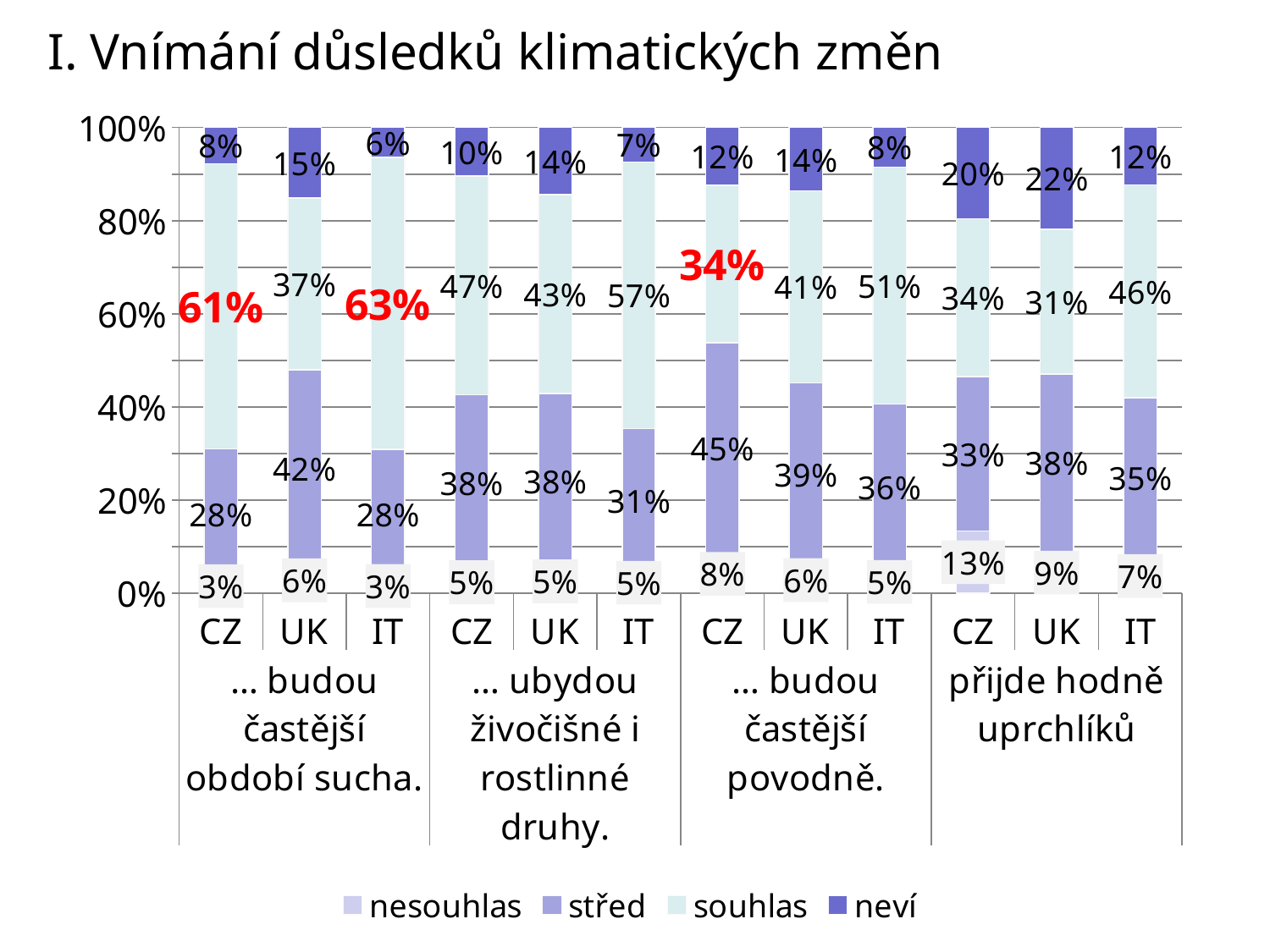
How many bars are plotted in the chart? 12 What is the 'střed' value for CZ under '… budou častější povodně.'? 45% What is the 'neví' value for UK under 'přijde hodně uprchlíků'? 22% What is the 'nesouhlas' value for CZ under 'přijde hodně uprchlíků'? 13% Which series is shown in the darkest blue colour at the top of each bar? neví How many series does the legend list? 4 What kind of chart is shown on the slide? stacked bar chart What is the difference between the 'souhlas' values for IT and UK under '… budou častější období sucha.'? 26% Which bar has the lowest 'neví' value? IT under '… budou častější období sucha.' (6%) What is the 'souhlas' value for CZ under '… budou častější období sucha.'? 61% Which bar has the highest 'souhlas' value? IT under '… budou častější období sucha.' (63%) Which is larger: the 'souhlas' value for CZ or for UK under '… budou častější povodně.'? UK